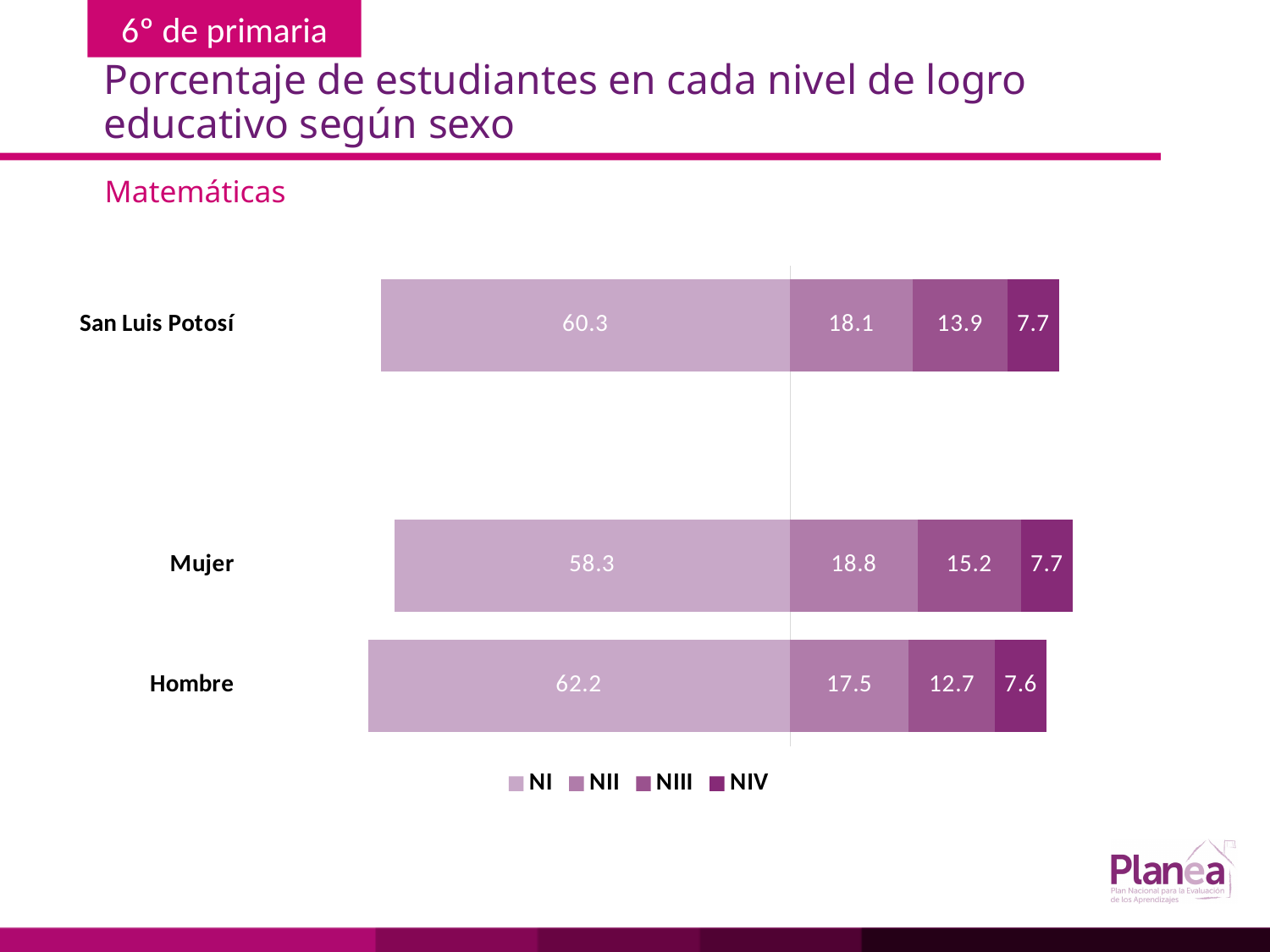
What is the NIV value for Hombre? 7.6 What is the NIII value for Mujer? 15.2 Which category has the highest NI value? Hombre What is the total of the stacked bar for Mujer? 100.0 What is the NII value for San Luis Potosí? 18.1 What is the NI value for Hombre? 62.2 What is the difference between the NI values for Hombre and Mujer? 3.9 What kind of chart is shown on the slide? Stacked bar chart How many categories are shown on the chart? 3 How many series does the legend list? 4 Which is larger, the NII value for Mujer or the NII value for Hombre? Mujer Which category has the lowest NIII value? Hombre